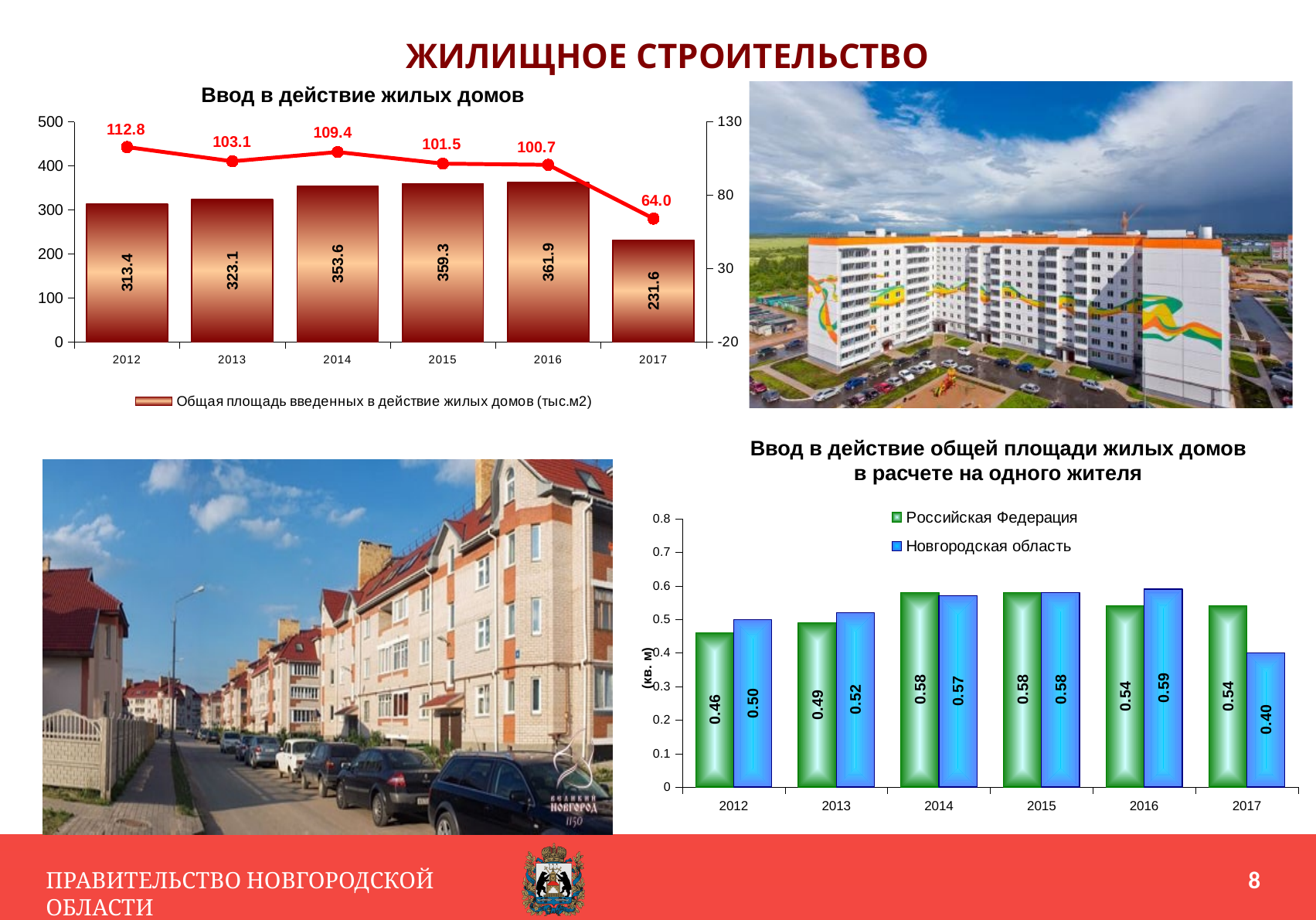
In the chart 'Ввод в действие жилых домов', which year has the highest bar value? 2016 In the chart 'Ввод в действие общей площади жилых домов в расчете на одного жителя', what is the difference between Новгородская область and Российская Федерация in 2012? 0.04 In the chart 'Ввод в действие жилых домов', what is the value of the bar for 2016? 361.9 In the chart 'Ввод в действие жилых домов', which year has the lowest bar value? 2017 In the chart 'Ввод в действие общей площади жилых домов в расчете на одного жителя', which is larger in 2017: Российская Федерация or Новгородская область? Российская Федерация In the chart 'Ввод в действие общей площади жилых домов в расчете на одного жителя', how many series does the legend list? 2 In the chart 'Ввод в действие общей площади жилых домов в расчете на одного жителя', what is the value for Новгородская область in 2016? 0.59 In the chart 'Ввод в действие жилых домов', what is the difference between the bar values for 2016 and 2017? 130.3 In the chart 'Ввод в действие жилых домов', what is the value of the red line point for 2017? 64.0 In the chart 'Ввод в действие жилых домов', how many years are shown on the x axis? 6 In the chart 'Ввод в действие жилых домов', what is the legend entry shown below the chart? Общая площадь введенных в действие жилых домов (тыс.м2) In the chart 'Ввод в действие общей площади жилых домов в расчете на одного жителя', what is the value for Российская Федерация in 2013? 0.49